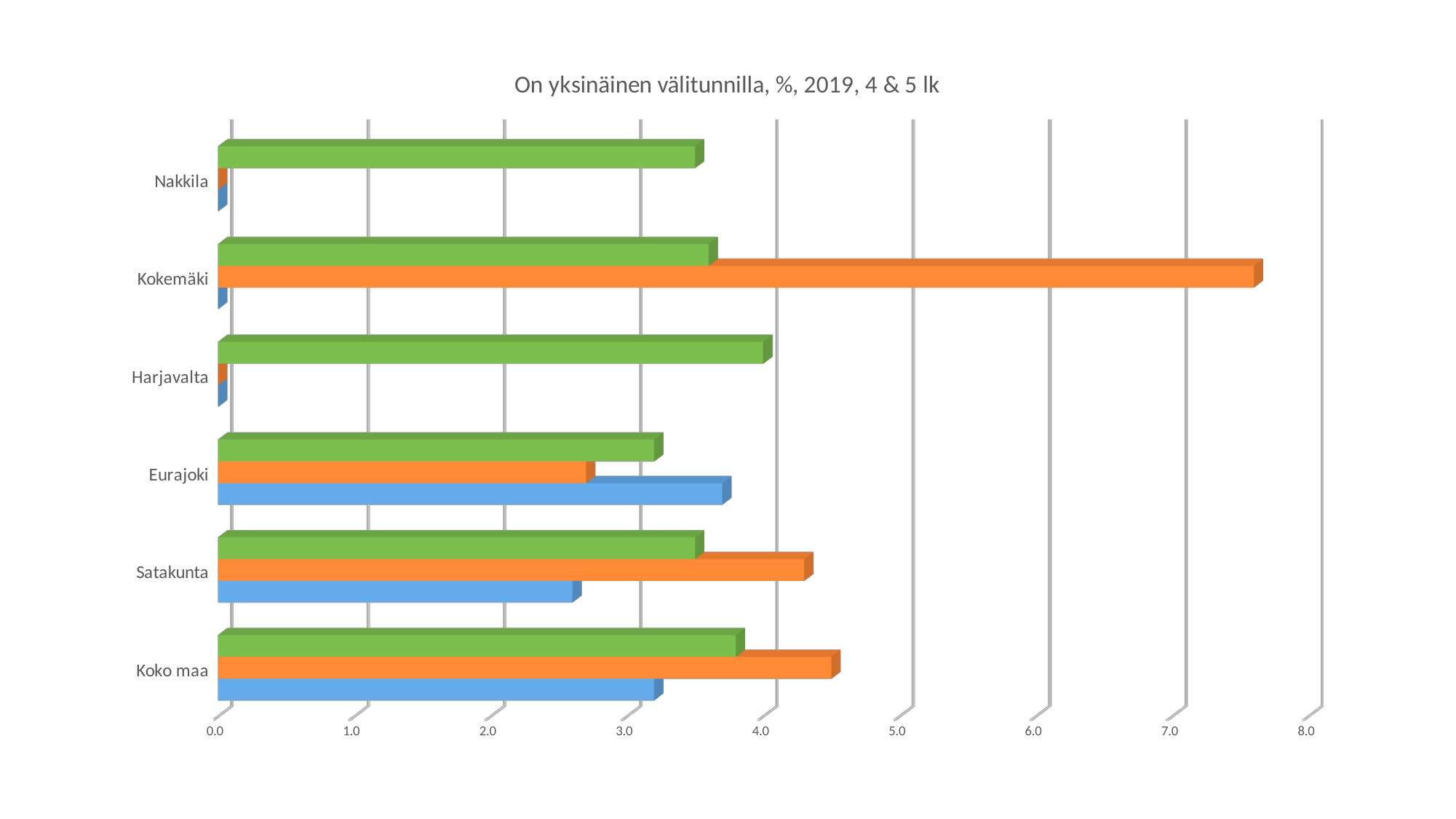
Which has the larger orange bar, Kokemäki or Koko maa? Kokemäki Is the orange bar for Eurajoki greater or less than 3.0? less Is the orange bar for Koko maa greater or less than 4.0? greater How many categories are shown on the vertical axis of the chart? 6 What kind of chart is shown on the slide? bar chart For Satakunta, which bar is longer, the orange bar or the blue bar? orange Is the blue bar for Satakunta greater or less than 3.0? less Which has the larger blue bar, Eurajoki or Satakunta? Eurajoki Which category has the longest orange bar? Kokemäki What is the title of the chart? On yksinäinen välitunnilla, %, 2019, 4 & 5 lk